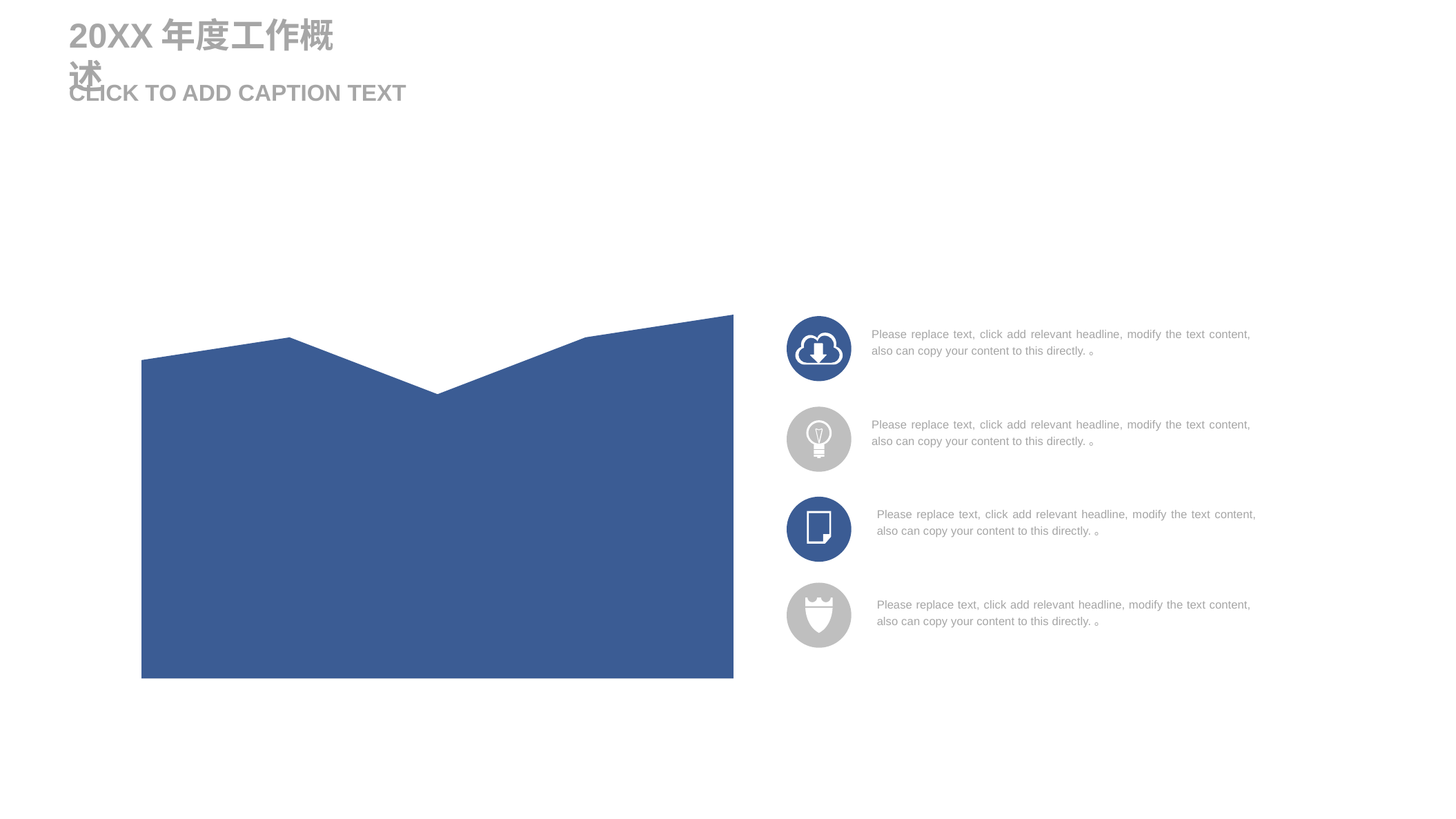
What kind of chart is shown on the left of the slide? area chart How many data points (vertices) does the area chart's top edge have? 5 Is the right end of the area chart higher or lower than its left end? higher Does the area chart display any axis labels or data labels? No What colour is the filled area in the chart? blue